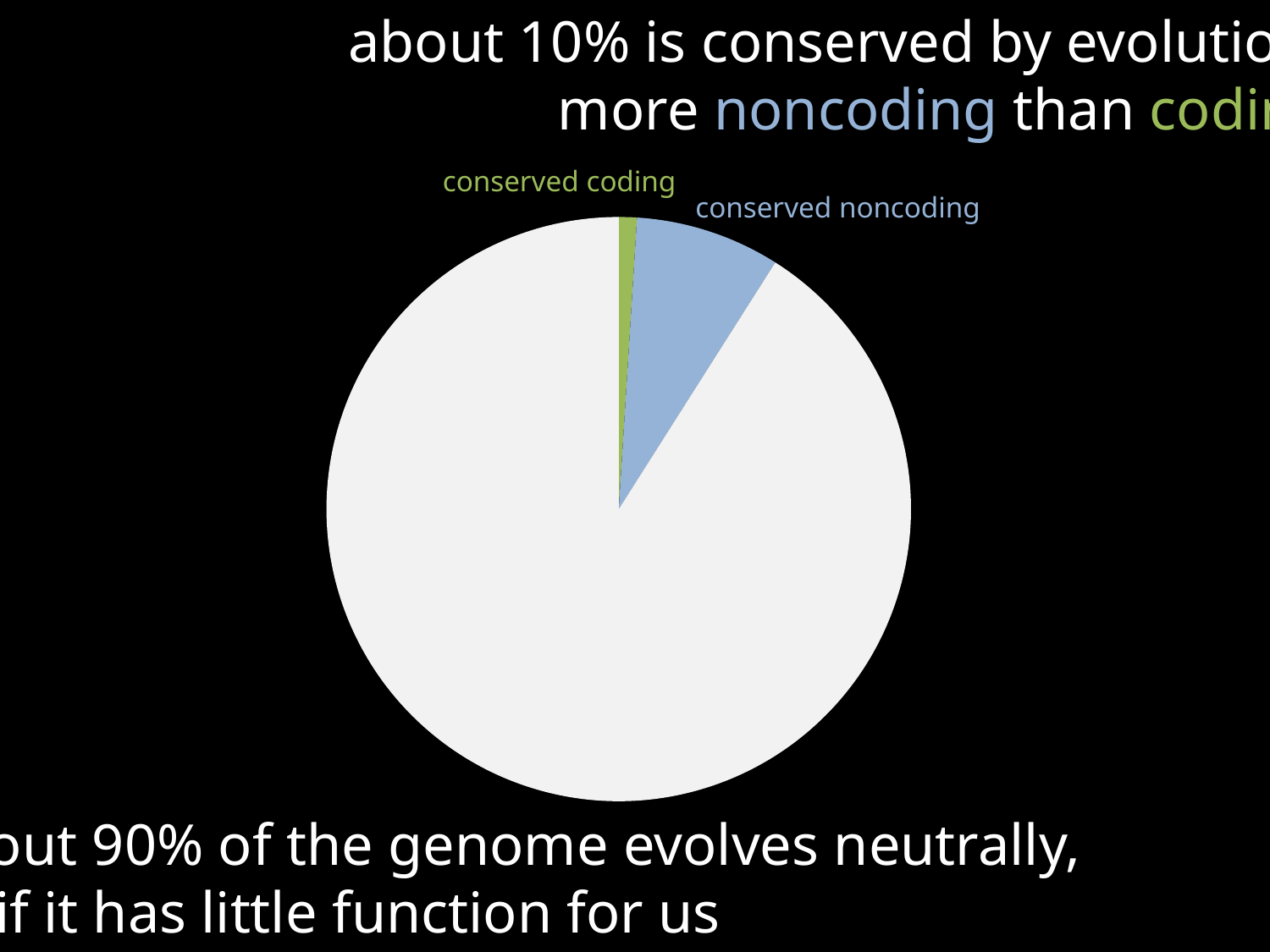
How many slices are labelled in the pie chart? 2 Which labelled slice of the pie chart is the smallest? conserved coding What colour is the conserved coding slice in the pie chart? green Of the two labelled slices in the pie chart, which is the largest? conserved noncoding How many slices does the pie chart have in total? 3 Which is larger in the pie chart, the conserved noncoding slice or the conserved coding slice? conserved noncoding What colour is the conserved noncoding slice in the pie chart? blue What kind of chart is shown on the slide? pie chart